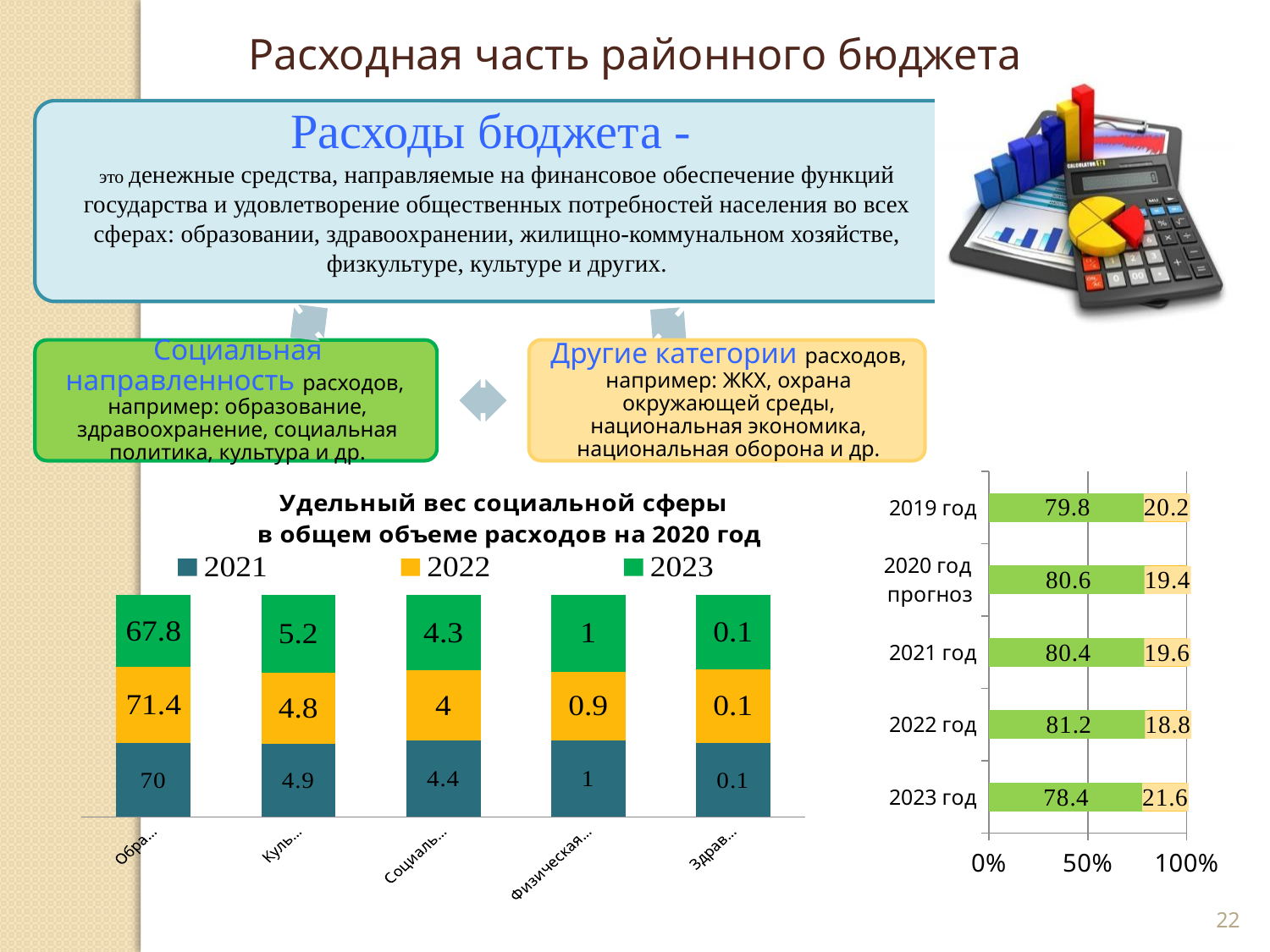
In the horizontal bar chart on the right of the slide, which year has the highest green segment value? 2022 год In the horizontal bar chart on the right of the slide, what is the value of the green segment for 2022 год? 81.2 In the chart "Удельный вес социальной сферы в общем объеме расходов на 2020 год", what is the 2023 value in the second stacked bar from the left? 5.2 In the horizontal bar chart on the right of the slide, what is the value of the orange segment for 2023 год? 21.6 In the horizontal bar chart on the right of the slide, what is the total of the two segments for 2019 год? 100 How many categories are shown on the x axis of the chart "Удельный вес социальной сферы в общем объеме расходов на 2020 год"? 5 In the chart "Удельный вес социальной сферы в общем объеме расходов на 2020 год", which is larger in the leftmost bar: the 2021 value or the 2022 value? 2022 In the chart "Удельный вес социальной сферы в общем объеме расходов на 2020 год", what is the 2022 value in the leftmost stacked bar? 71.4 In the horizontal bar chart on the right of the slide, which year has the lowest green segment value? 2023 год How many series does the legend of the chart "Удельный вес социальной сферы в общем объеме расходов на 2020 год" list? 3 In the horizontal bar chart on the right of the slide, what is the difference between the green segment values for 2022 год and 2023 год? 2.8 What type of chart is the chart titled "Удельный вес социальной сферы в общем объеме расходов на 2020 год"? bar chart